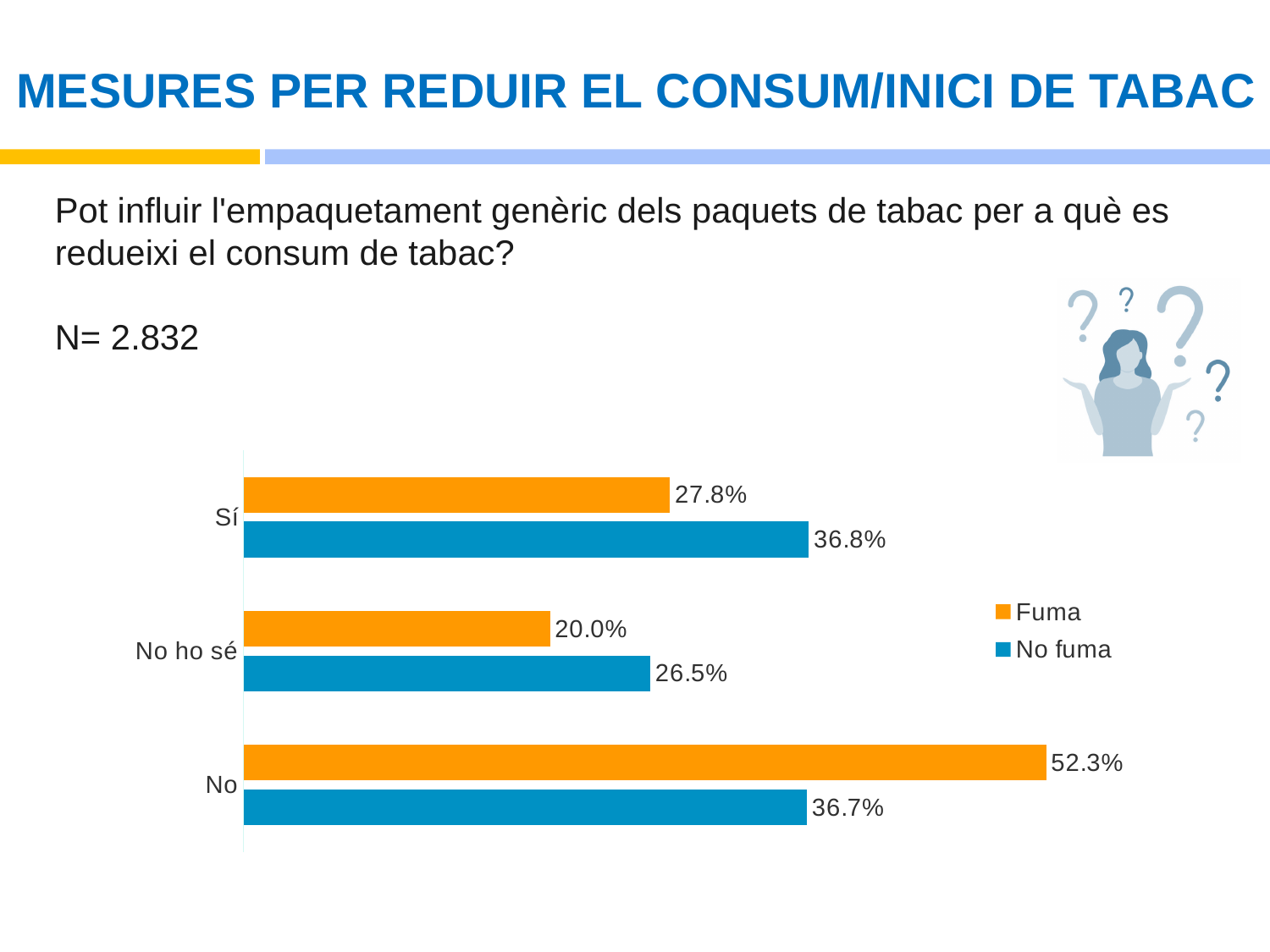
In the "Sí" category, which series has the larger value, "Fuma" or "No fuma"? No fuma How many categories are shown on the chart? 3 What is the value for "No fuma" in the "No ho sé" category? 26.5% What is the value for "Fuma" in the "No" category? 52.3% What is the value for "No fuma" in the "Sí" category? 36.8% What kind of chart is shown on the slide? Bar chart Which category has the lowest value for the "No fuma" series? No ho sé How many series does the legend list? 2 What is the value for "Fuma" in the "No ho sé" category? 20.0% Which colour represents the "Fuma" series? Orange What is the difference between the "Fuma" and "No fuma" values in the "No" category? 15.6% Which category has the highest value for the "Fuma" series? No